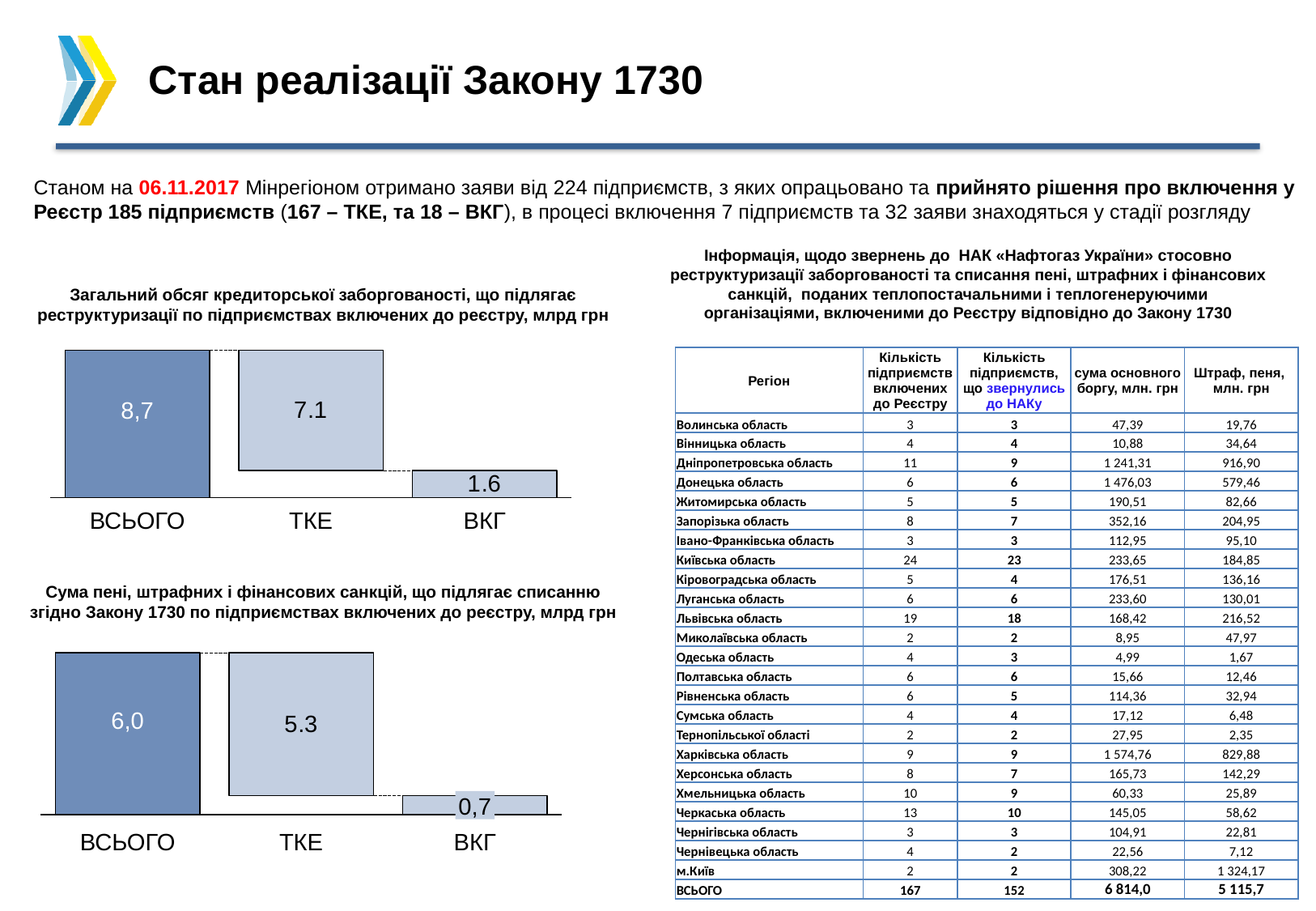
In the top chart (Загальний обсяг кредиторської заборгованості), what is the value for ВСЬОГО? 8,7 In the top chart (Загальний обсяг кредиторської заборгованості), which category has the lowest value? ВКГ In the top chart (Загальний обсяг кредиторської заборгованості), what is the value for ТКЕ? 7.1 In the bottom chart (Сума пені, штрафних і фінансових санкцій), what is the value for ВКГ? 0,7 In the top chart (Загальний обсяг кредиторської заборгованості), what is the difference between the values for ТКЕ and ВКГ? 5.5 In the bottom chart (Сума пені, штрафних і фінансових санкцій), which category has the highest value? ВСЬОГО In the bottom chart (Сума пені, штрафних і фінансових санкцій), what is the difference between the values for ТКЕ and ВКГ? 4.6 In the bottom chart (Сума пені, штрафних і фінансових санкцій), what is the value for ВСЬОГО? 6,0 In the bottom chart (Сума пені, штрафних і фінансових санкцій), which is larger, the value for ТКЕ or the value for ВКГ? ТКЕ How many categories are shown in the top chart (Загальний обсяг кредиторської заборгованості)? 3 In the bottom chart (Сума пені, штрафних і фінансових санкцій), what is the value for ТКЕ? 5.3 In the top chart (Загальний обсяг кредиторської заборгованості), what is the value for ВКГ? 1.6